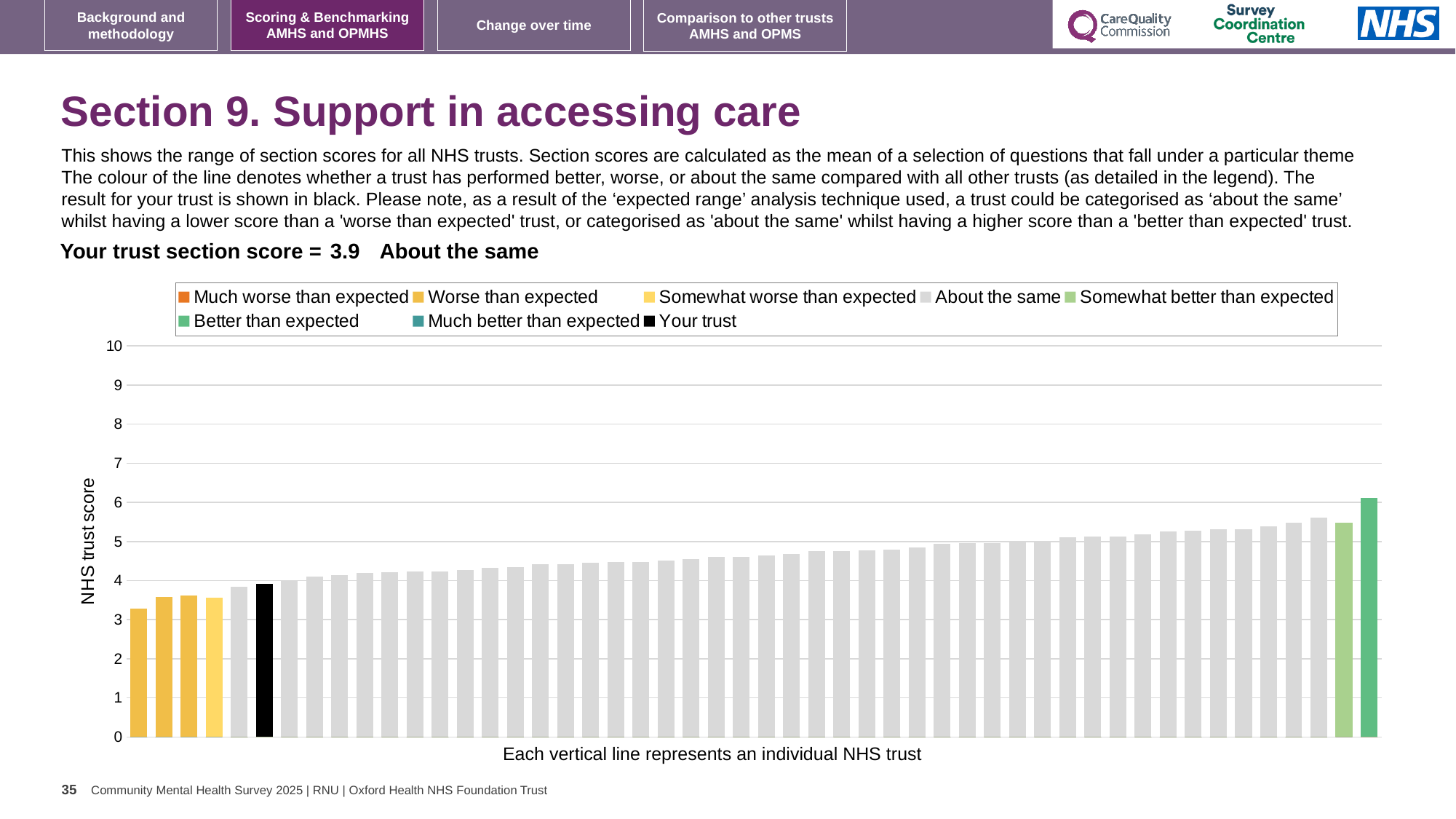
Is the value of the tallest bar (rightmost) greater or less than 5? greater What is the highest value shown on the vertical axis? 10 How many entries does the chart legend list? 8 Is the value of the shortest bar (leftmost) greater or less than 4? less What kind of chart is shown on the slide? bar chart Which legend category does the tallest bar belong to? Better than expected Which category is your trust's section score placed in? About the same Do the bar values rise or fall from left to right along the x axis? rise What is the section score for your trust shown on the slide? 3.9 What is the title of the vertical axis? NHS trust score Is the value of the black bar for your trust greater or less than 3? greater